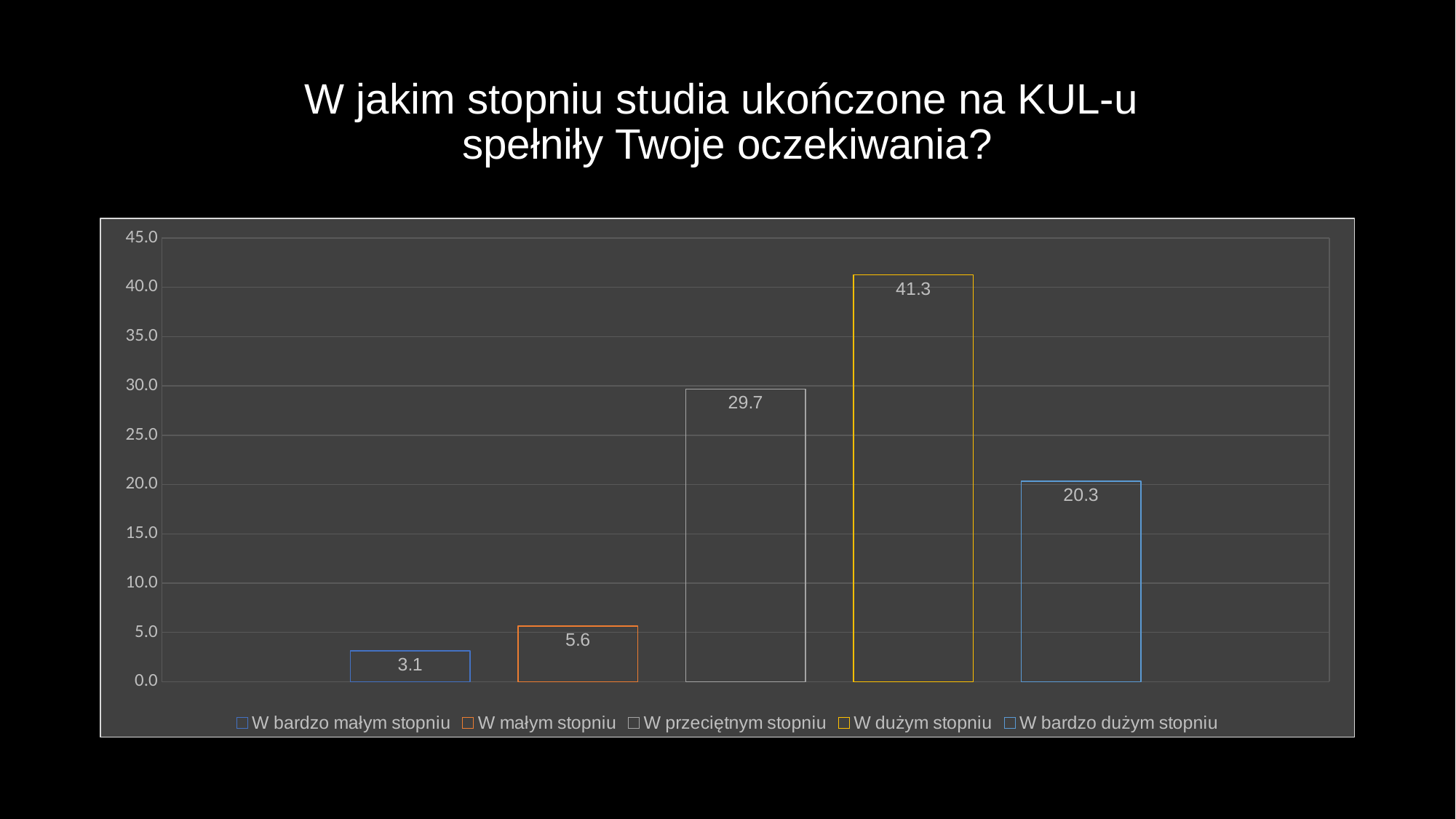
Which category has the lowest value? W bardzo małym stopniu How many series does the legend list? 5 Which category has the highest value? W dużym stopniu Is the value for "W przeciętnym stopniu" greater or less than 25.0? greater What is the value for "W dużym stopniu"? 41.3 What is the value for "W przeciętnym stopniu"? 29.7 What is the value for "W bardzo dużym stopniu"? 20.3 What is the value for "W bardzo małym stopniu"? 3.1 What kind of chart is shown on the slide? bar chart What is the title of the chart on the slide? W jakim stopniu studia ukończone na KUL-u spełniły Twoje oczekiwania? Which is larger, the value for "W bardzo dużym stopniu" or the value for "W małym stopniu"? W bardzo dużym stopniu What is the difference between the values for "W dużym stopniu" and "W przeciętnym stopniu"? 11.6